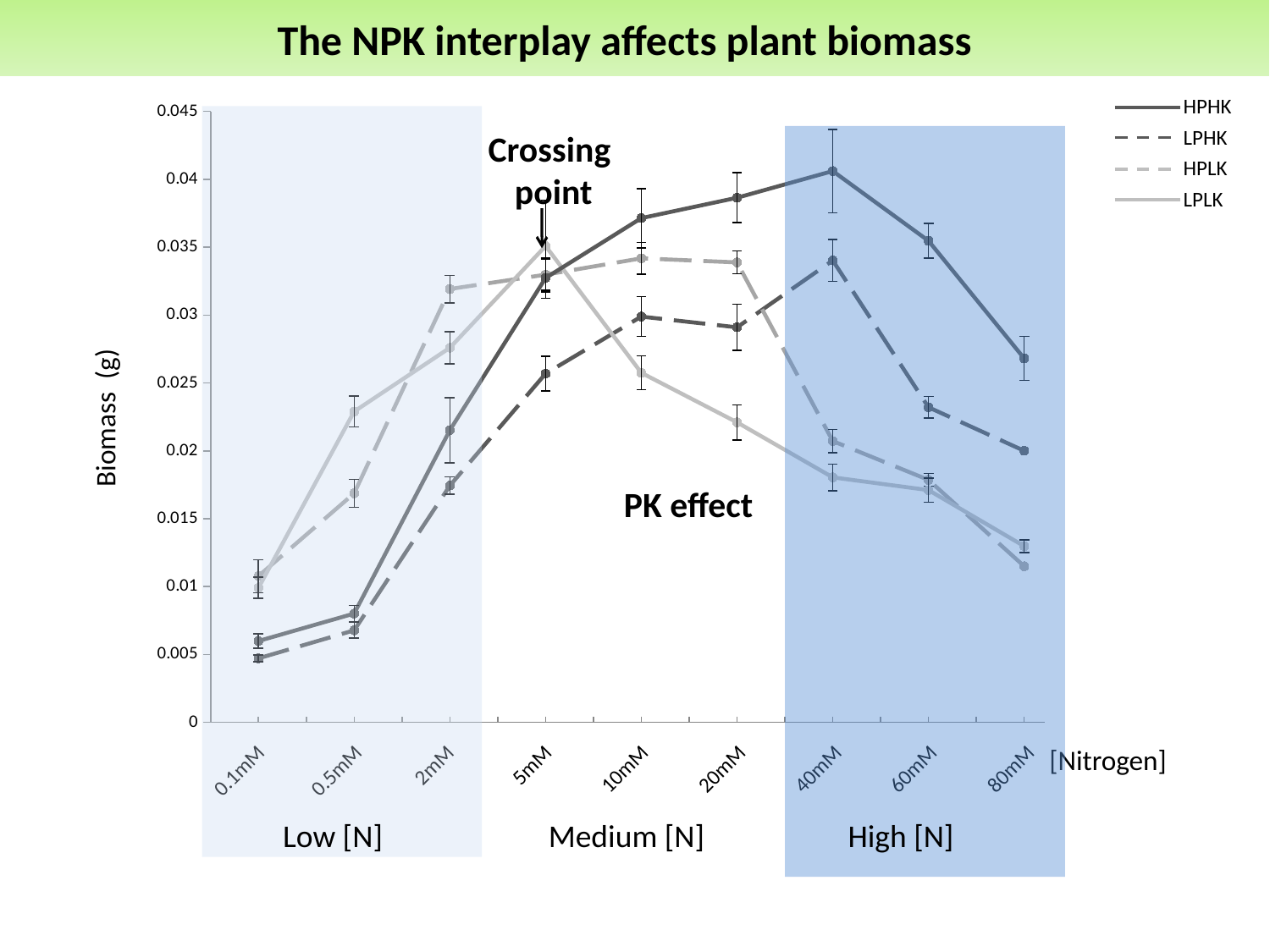
At which nitrogen concentration does the HPHK series reach its highest biomass? 40mM What kind of chart is shown on the slide? line chart Does the HPHK series rise or fall from 40mM to 80mM? fall How many nitrogen concentrations are plotted along the x axis? 9 How many series does the legend list? 4 Which series has the highest biomass at 80mM? HPHK Which series has the lowest biomass at 20mM? LPLK Is the value for HPLK at 10mM greater or less than 0.03? greater Is the value for LPLK at 80mM greater or less than 0.015? less At 2mM, which series has the larger biomass, HPLK or HPHK? HPLK Is the value for HPHK at 40mM greater or less than 0.035? greater What is the title of the y axis? Biomass (g)